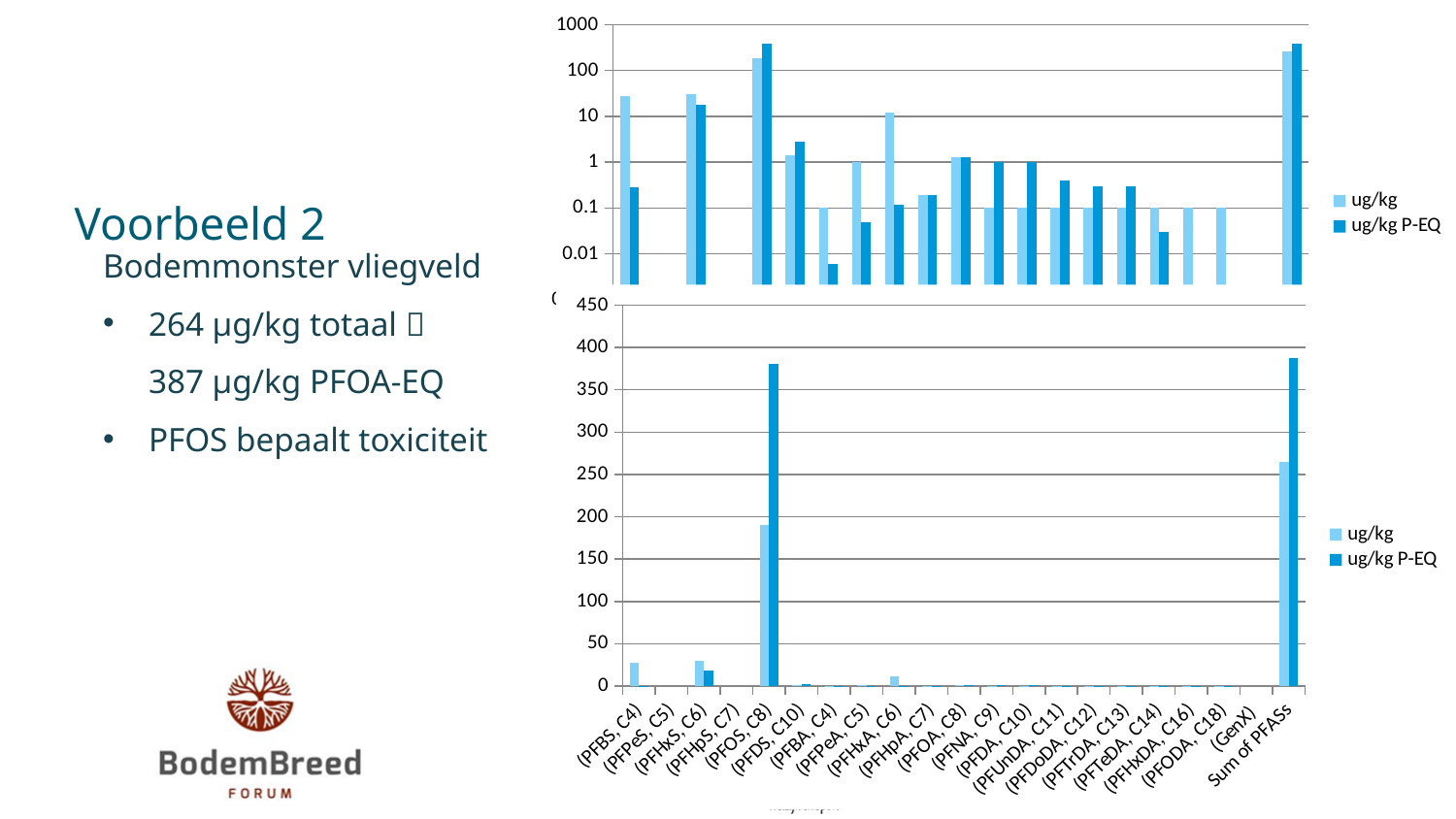
In the bottom chart, is the ug/kg P-EQ value for (PFOS, C8) greater or less than 350? greater What kind of chart is the bottom chart on the slide? bar chart In the top chart, for (PFBS, C4), which series has the larger value: ug/kg or ug/kg P-EQ? ug/kg What are the two series named in the legend of the bottom chart? ug/kg and ug/kg P-EQ How many series does the legend of the top chart list? 2 In the bottom chart, which category has the highest ug/kg P-EQ value? Sum of PFASs In the bottom chart, is the ug/kg value for (PFHxS, C6) greater or less than 50? less How many categories are shown on the x axis of the bottom chart? 21 In the top chart, for (PFNA, C9), which series has the larger value: ug/kg or ug/kg P-EQ? ug/kg P-EQ In the bottom chart, is the ug/kg value for Sum of PFASs greater or less than 200? greater In the bottom chart, which individual compound (excluding Sum of PFASs) has the highest ug/kg value? (PFOS, C8)